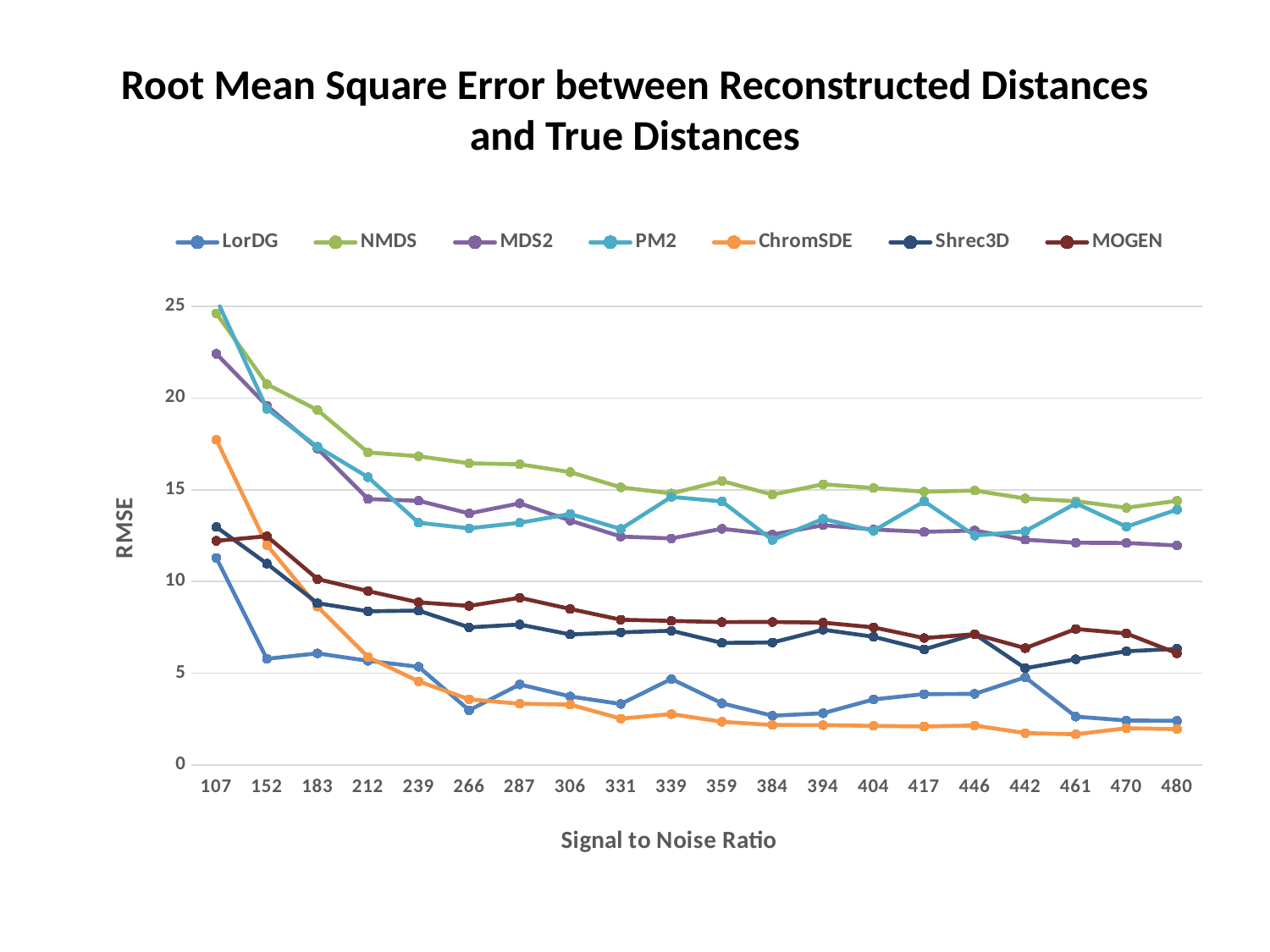
At a Signal to Noise Ratio of 212, which series has the highest RMSE? NMDS How many series does the legend list? 7 Is the RMSE for NMDS at a Signal to Noise Ratio of 107 greater or less than 20? greater What is the title of the chart? Root Mean Square Error between Reconstructed Distances and True Distances At a Signal to Noise Ratio of 404, which series has the lowest RMSE? ChromSDE At a Signal to Noise Ratio of 107, which has the higher RMSE, NMDS or LorDG? NMDS Is the RMSE for ChromSDE at a Signal to Noise Ratio of 480 greater or less than 5? less What is the label of the y axis? RMSE What kind of chart is shown on the slide? line chart At a Signal to Noise Ratio of 152, which has the higher RMSE, MOGEN or Shrec3D? MOGEN How many Signal to Noise Ratio values are plotted along the x axis? 20 Is the RMSE for MOGEN at a Signal to Noise Ratio of 107 greater or less than 10? greater